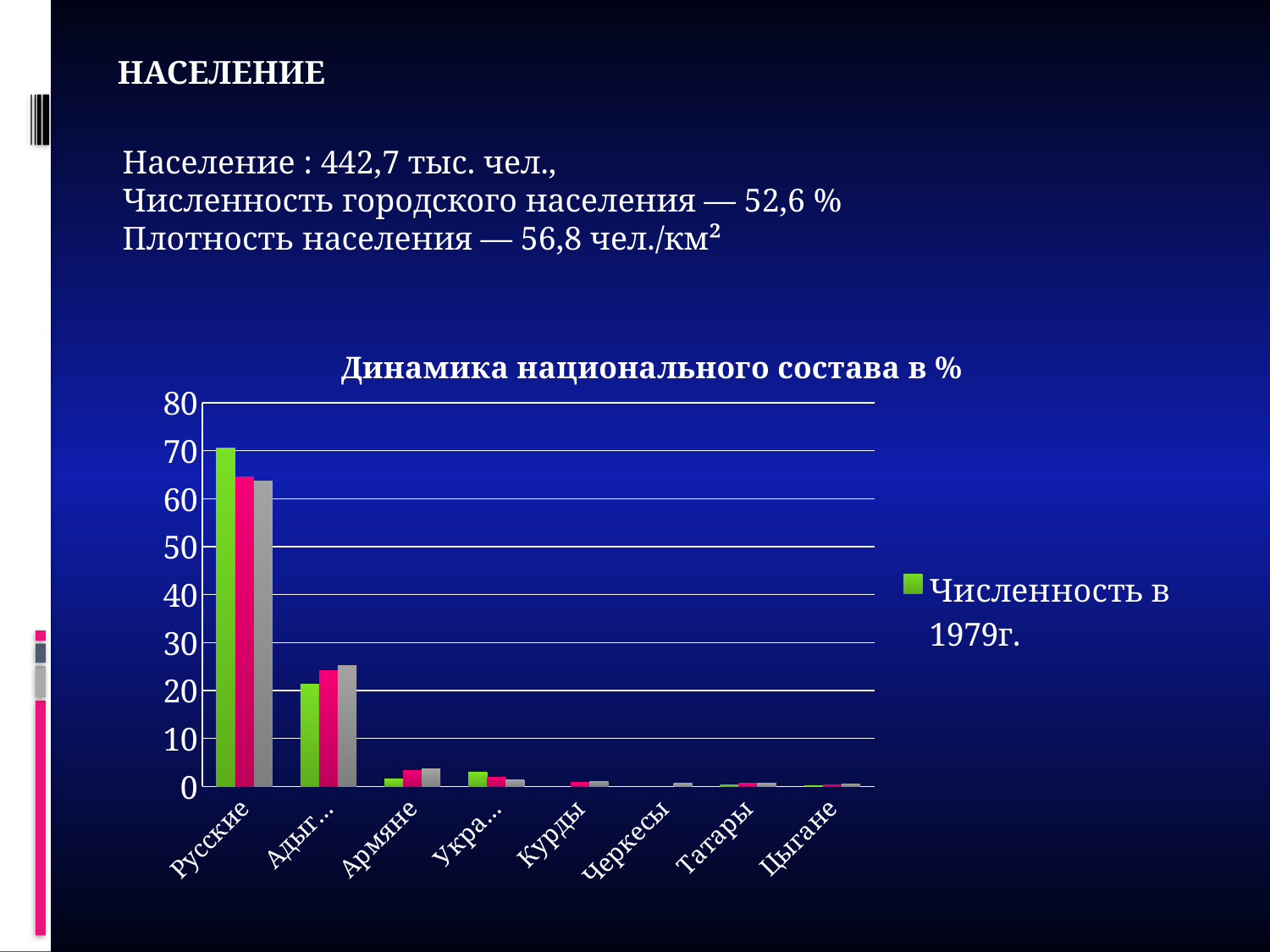
How many categories are shown on the x axis of the chart? 8 Is the green bar for Армяне greater or less than 10? less Do the values generally rise or fall moving from left to right along the x axis? fall Which has larger values, Армяне or the second category from the left (Адыг...)? Адыг... Is the green bar for Русские greater or less than 60? greater Is the gray bar for Курды greater or less than 10? less Which category has the highest values in the chart? Русские What is the title of the chart? Динамика национального состава в % Which has larger values, Русские or Армяне? Русские What legend entry is shown next to the chart? Численность в 1979г. What type of chart is shown on the slide? bar chart